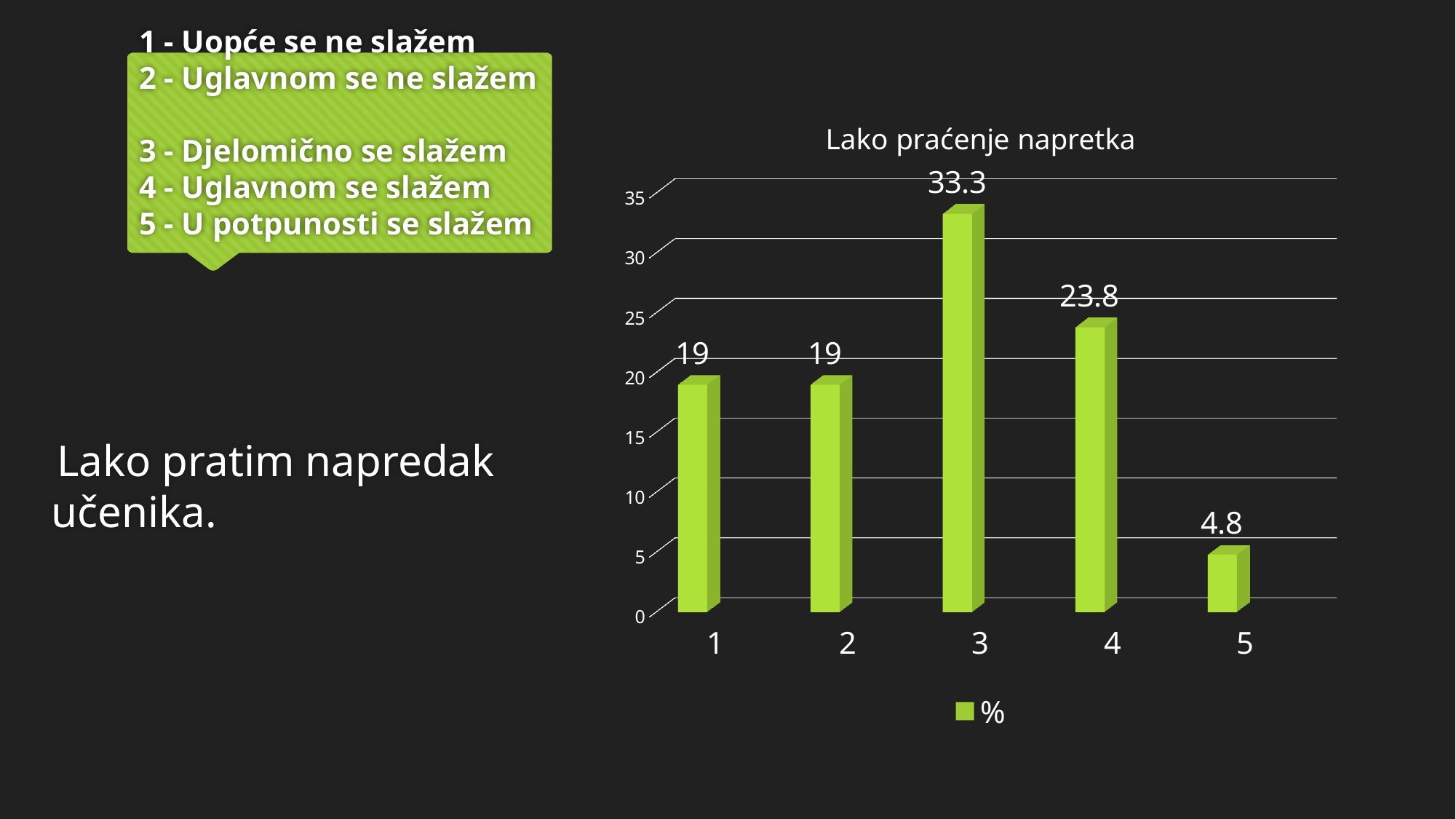
Which category has the highest value? 3 What is the value for category 5? 4.8 Is the value for category 3 greater or less than 30? greater What kind of chart is shown? bar chart How many series does the legend list? 1 Which category has the lowest value? 5 How many categories are shown on the x axis? 5 What is the value for category 4? 23.8 Which is larger, the value for category 4 or the value for category 1? category 4 What is the title of the chart? Lako praćenje napretka What is the difference between the values for category 3 and category 4? 9.5 What is the value for category 3? 33.3